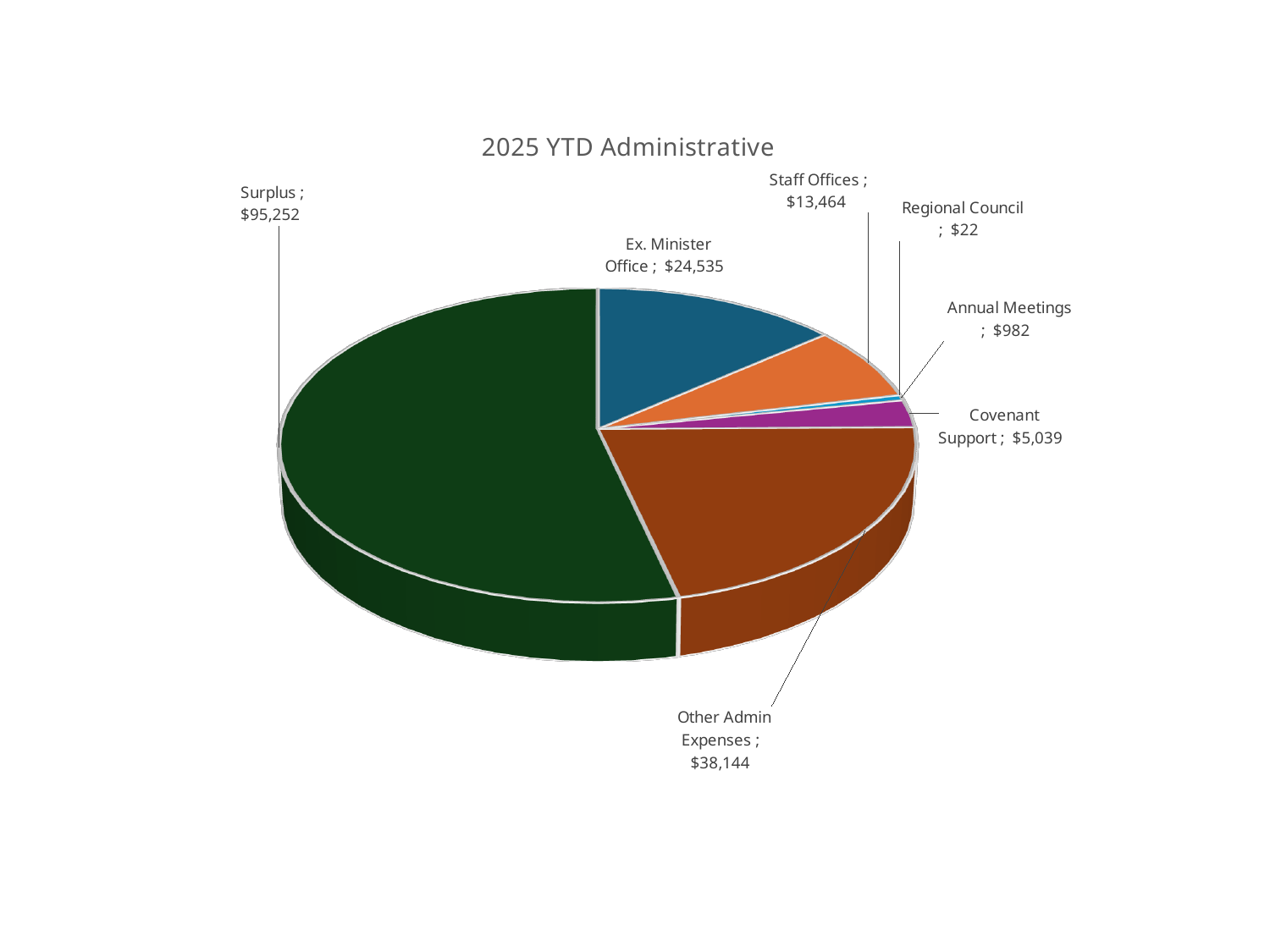
What is the title of the chart? 2025 YTD Administrative What is the value for Surplus? $95,252 What is the difference between Surplus and Other Admin Expenses? $57,108 What is the value for Other Admin Expenses? $38,144 What is the value for Ex. Minister Office? $24,535 What is the difference between Covenant Support and Annual Meetings? $4,057 What type of chart is shown on the slide? Pie chart Which category has the smallest value? Regional Council How many slices does the pie chart have? 7 Which is larger, Ex. Minister Office or Staff Offices? Ex. Minister Office Which category has the largest slice? Surplus What is the value for Covenant Support? $5,039